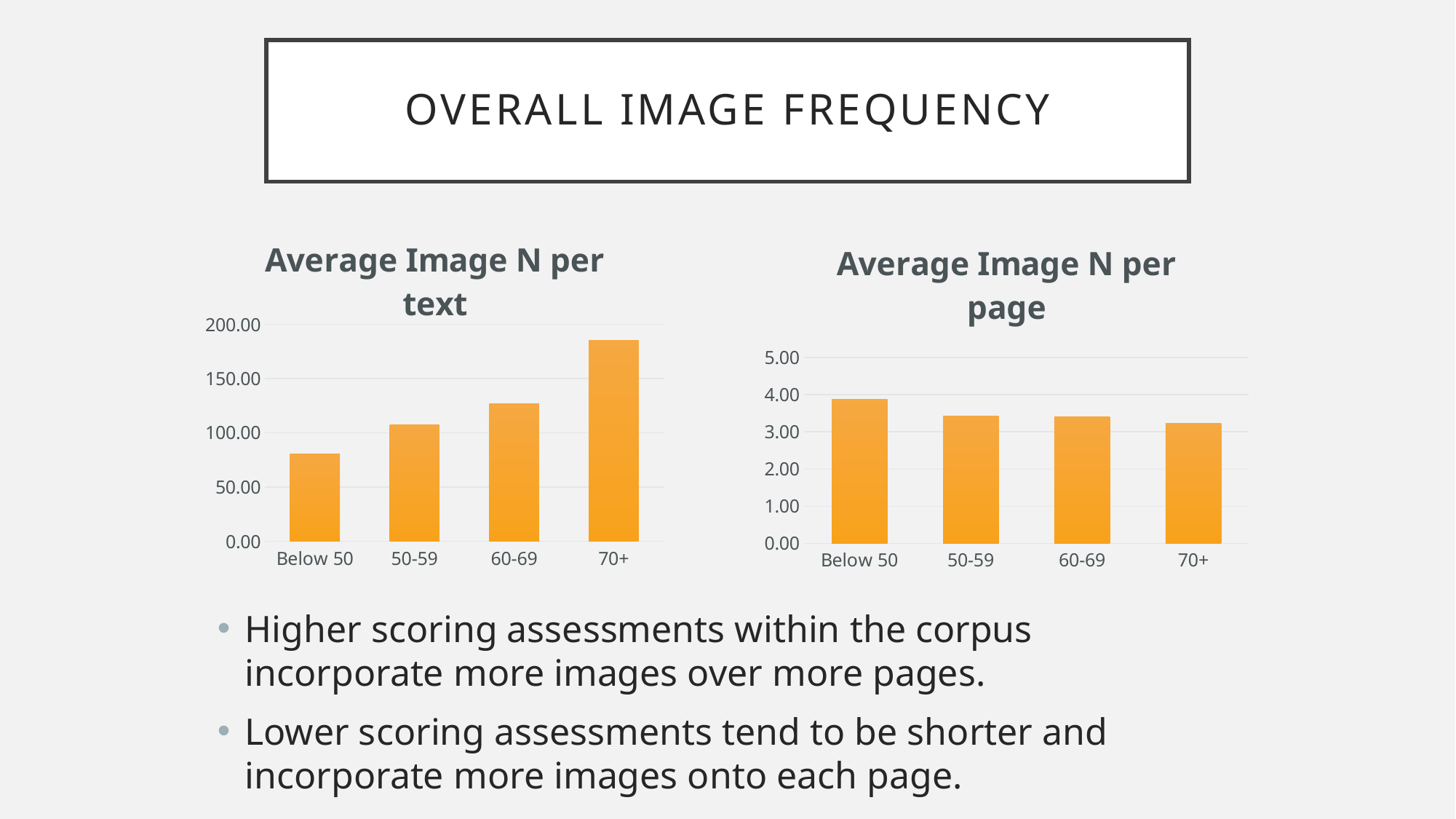
In the 'Average Image N per page' chart, which category has the lowest value? 70+ In the 'Average Image N per text' chart, what kind of chart is shown? bar chart In the 'Average Image N per text' chart, which category has the lowest value? Below 50 In the 'Average Image N per text' chart, is the value for Below 50 greater or less than 100.00? less In the 'Average Image N per text' chart, how many categories are plotted? 4 In the 'Average Image N per page' chart, is the value for 70+ greater or less than 3.00? greater In the 'Average Image N per text' chart, is the value for 70+ greater or less than 150.00? greater In the 'Average Image N per text' chart, which category has the highest value? 70+ In the 'Average Image N per page' chart, which is larger, the value for Below 50 or the value for 70+? Below 50 In the 'Average Image N per text' chart, do the values rise or fall from Below 50 to 70+? rise In the 'Average Image N per page' chart, which category has the highest value? Below 50